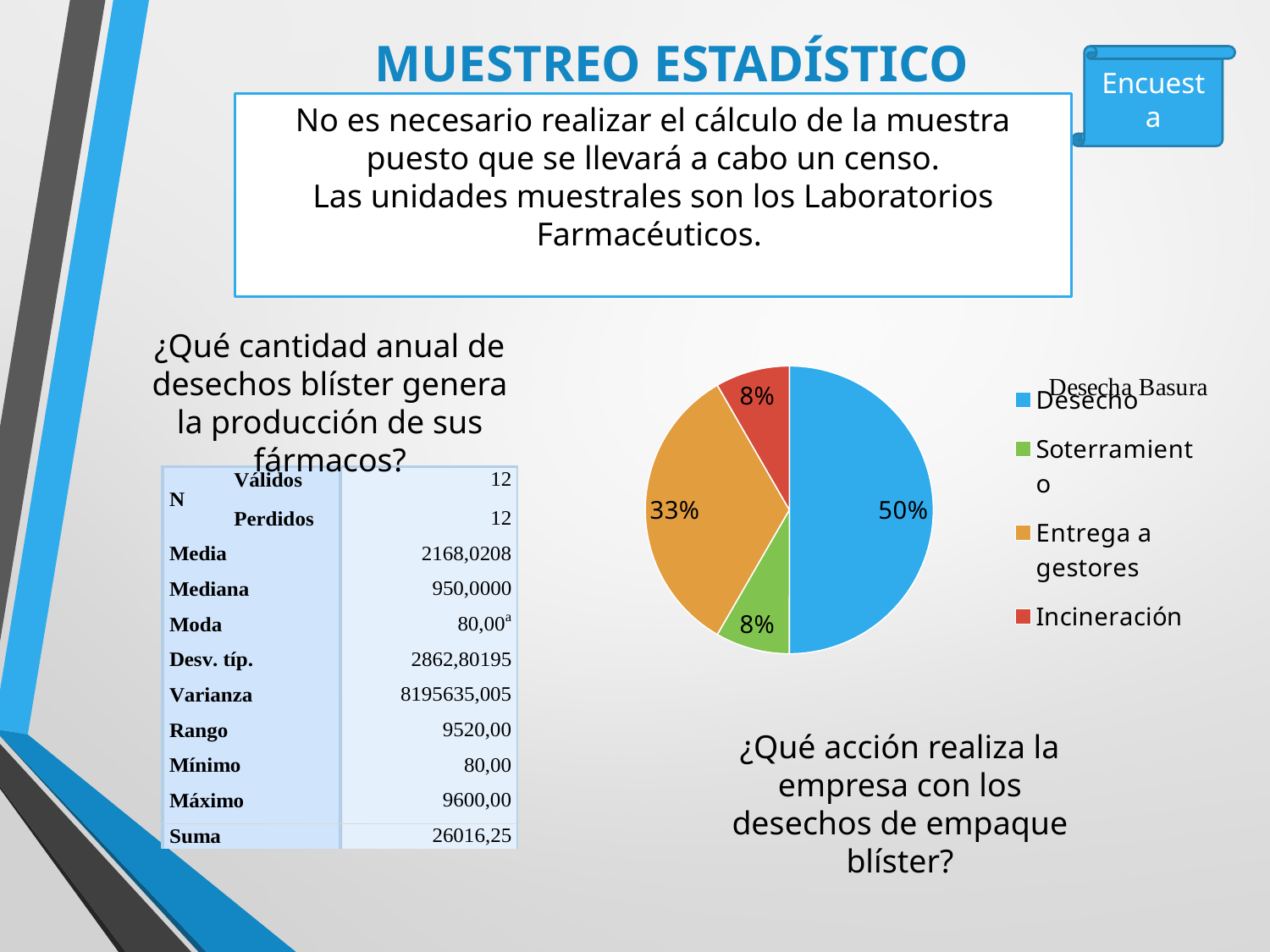
What is the difference in percentage points between the Desecho slice and the Entrega a gestores slice? 17 Which category has the largest slice of the pie? Desecho Which is larger, the slice for Entrega a gestores or the slice for Incineración? Entrega a gestores What is the difference in percentage points between the Entrega a gestores slice and the Soterramiento slice? 25 What share of the pie does Entrega a gestores represent? 33% What is the value shown for Soterramiento in the pie chart? 8% Which is larger, the slice for Desecho or the slice for Entrega a gestores? Desecho What is the value shown for Incineración in the pie chart? 8% How many slices does the pie chart have? 4 What colour is the Entrega a gestores slice in the pie chart? orange What share of the pie does Desecho represent? 50% What kind of chart is shown on the slide? pie chart